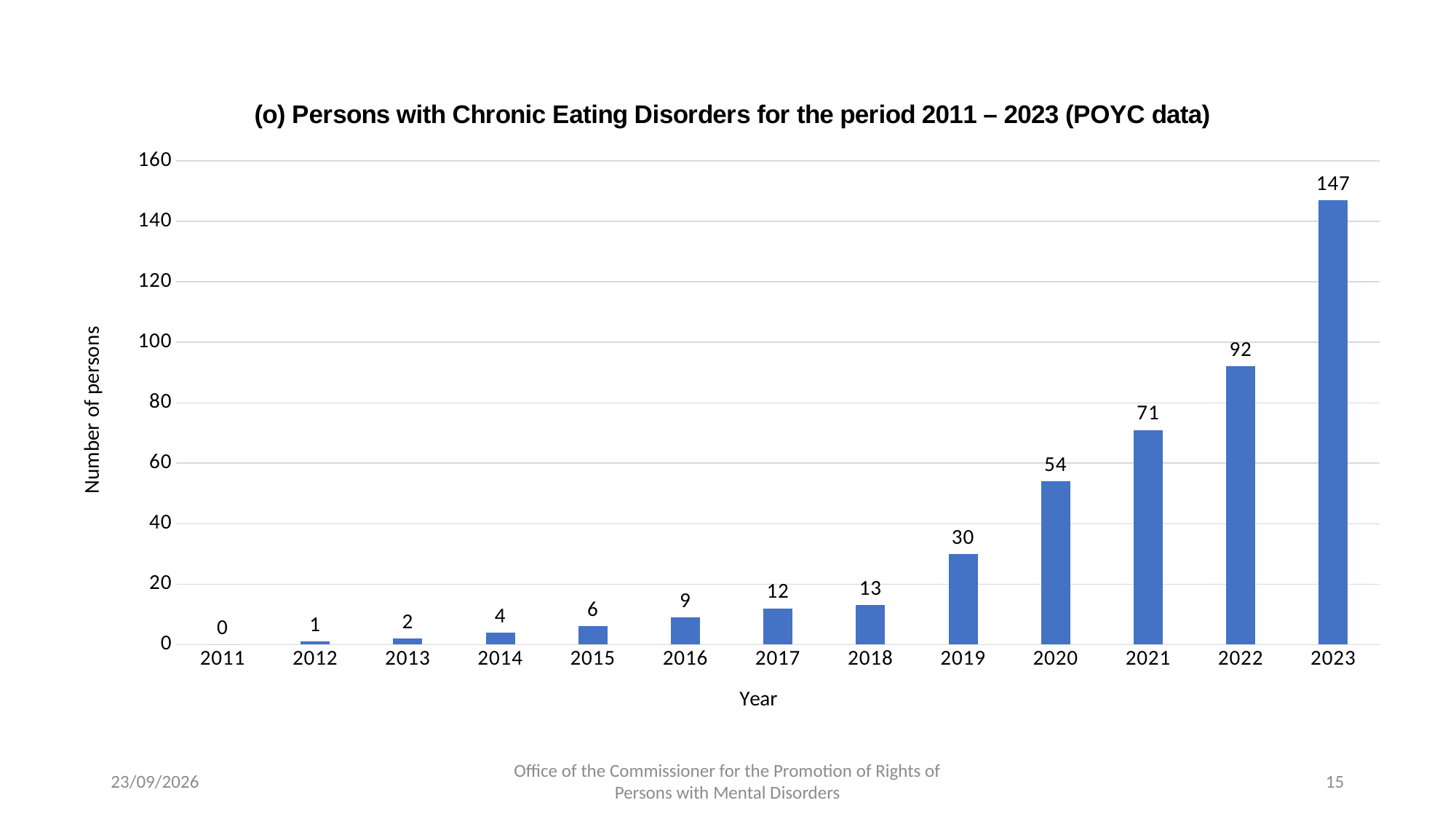
What is the number of persons with chronic eating disorders in 2019? 30 Which year has more persons with chronic eating disorders, 2018 or 2017? 2018 What kind of chart is shown on the slide? Bar chart Is the value for 2022 greater or less than 100? less Do the values rise or fall from 2011 to 2023? Rise How many years are shown on the x axis of the chart? 13 What is the number of persons with chronic eating disorders in 2016? 9 What is the number of persons with chronic eating disorders in 2023? 147 Which year has the highest number of persons with chronic eating disorders? 2023 What is the difference between the number of persons in 2023 and in 2022? 55 Which year has the lowest number of persons with chronic eating disorders? 2011 What is the difference between the number of persons in 2021 and in 2020? 17